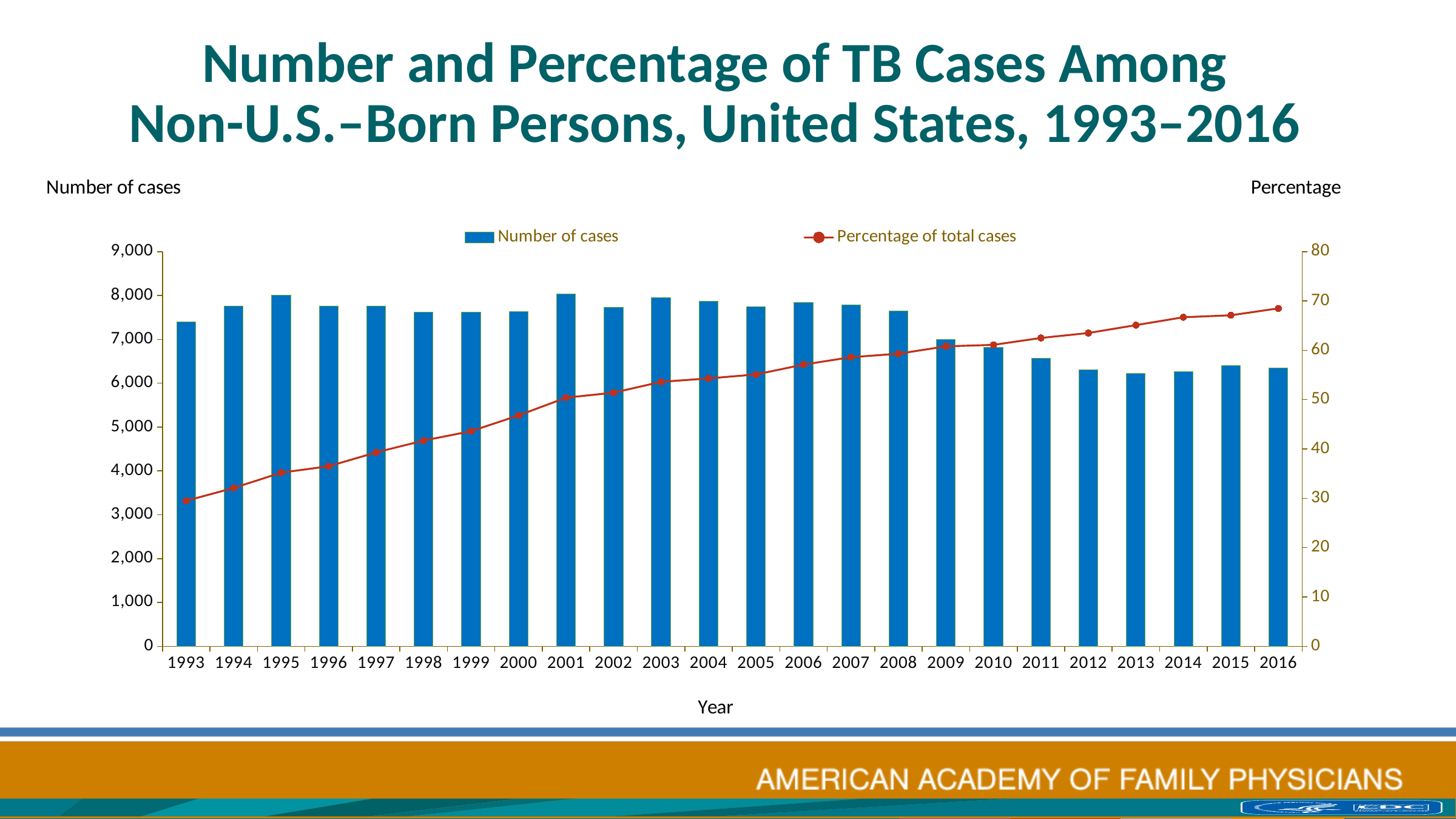
What is the label of the right-hand vertical axis? Percentage How many series does the legend list? 2 In which year is the percentage of total cases highest? 2016 Does the percentage of total cases rise or fall from 1993 to 2016? rise Which year has more cases, 1995 or 2013? 1995 Is the percentage of total cases in 2016 greater or less than 60? greater Is the number of cases in 2013 greater or less than 7,000? less Is the number of cases in 1993 greater or less than 7,000? greater What kind of chart is used to show the number of cases? bar chart In which year is the percentage of total cases lowest? 1993 How many years are shown on the x axis? 24